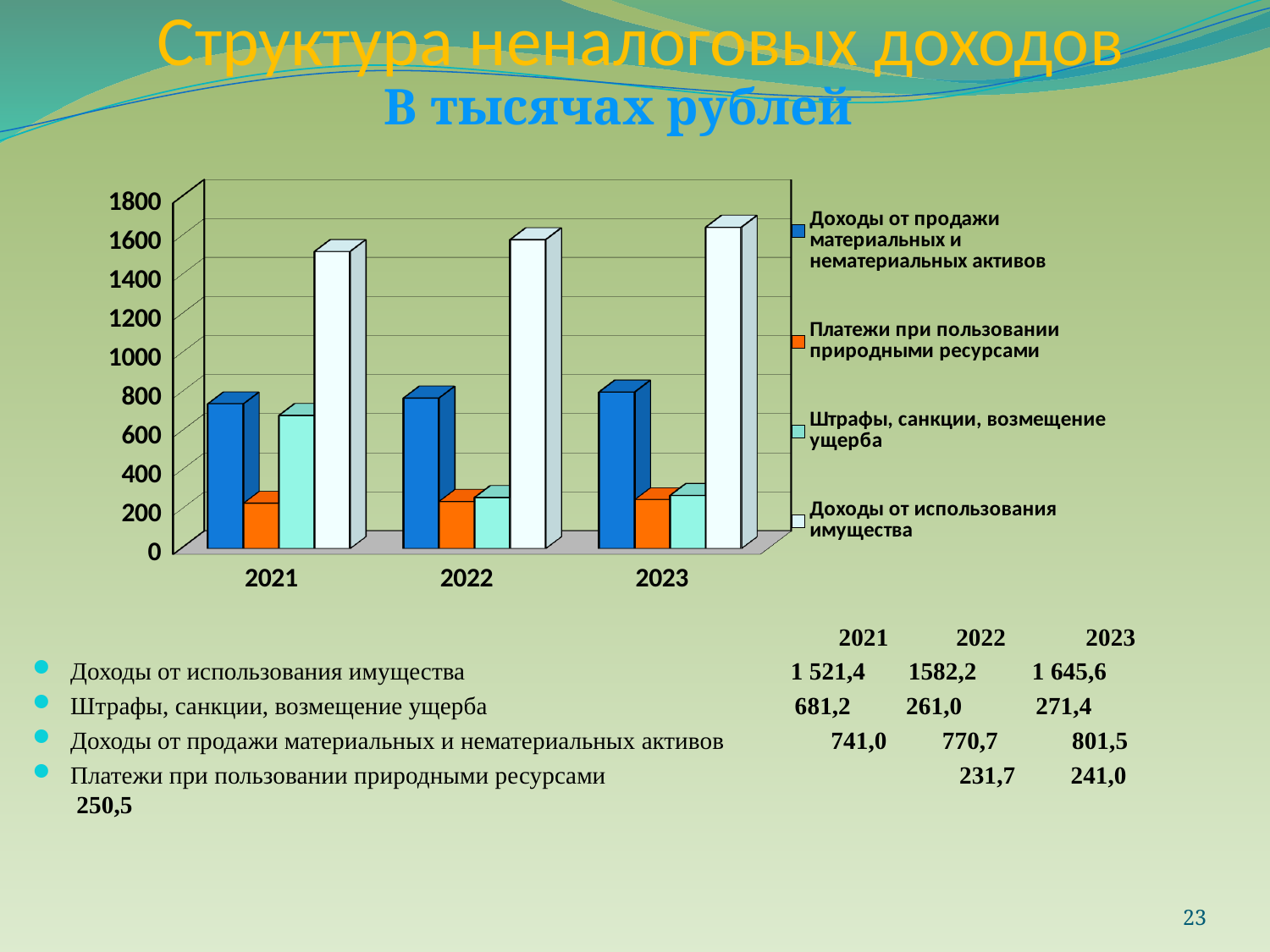
According to the figures on the slide, what is the value of Доходы от использования имущества in 2023? 1 645,6 According to the figures on the slide, what is the value of Штрафы, санкции, возмещение ущерба in 2021? 681,2 Do the bars for Доходы от использования имущества rise or fall from 2021 to 2023? rise What kind of chart is shown on the slide? bar chart How many years are shown on the x axis of the chart? 3 Is the bar for Доходы от использования имущества in 2021 greater or less than 1400? greater Which series has the lowest bar in 2021? Платежи при пользовании природными ресурсами How many series does the chart legend list? 4 Which series has the highest bar in 2023? Доходы от использования имущества Is the bar for Штрафы, санкции, возмещение ущерба in 2022 greater or less than 400? less In 2021, which is larger: the bar for Доходы от продажи материальных и нематериальных активов or the bar for Штрафы, санкции, возмещение ущерба? Доходы от продажи материальных и нематериальных активов Using the figures on the slide, what is the difference between Доходы от продажи материальных и нематериальных активов in 2023 and in 2021? 60,5